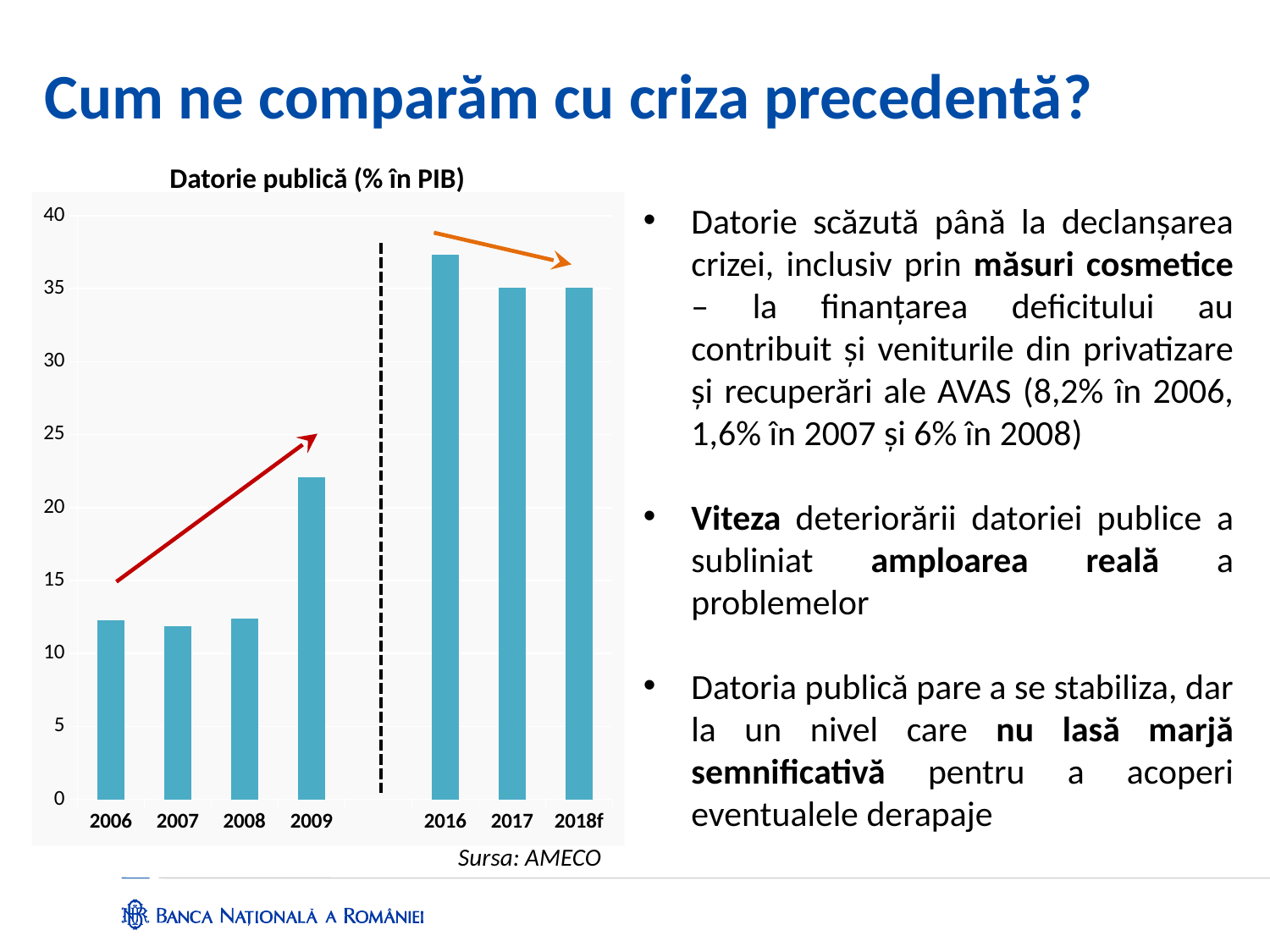
How many years (categories) are plotted on the chart? 7 Which year has the highest public debt value on the chart? 2016 Which is larger, the value for 2008 or the value for 2009? 2009 What kind of chart is shown on the slide? bar chart Is the value for 2009 greater or less than 20? greater Is the value for 2007 greater or less than 15? less Is the value for 2016 greater or less than 35? greater What source is cited below the chart? AMECO What is the title of the chart? Datorie publică (% în PIB) Do the values rise or fall from 2006 to 2009? rise